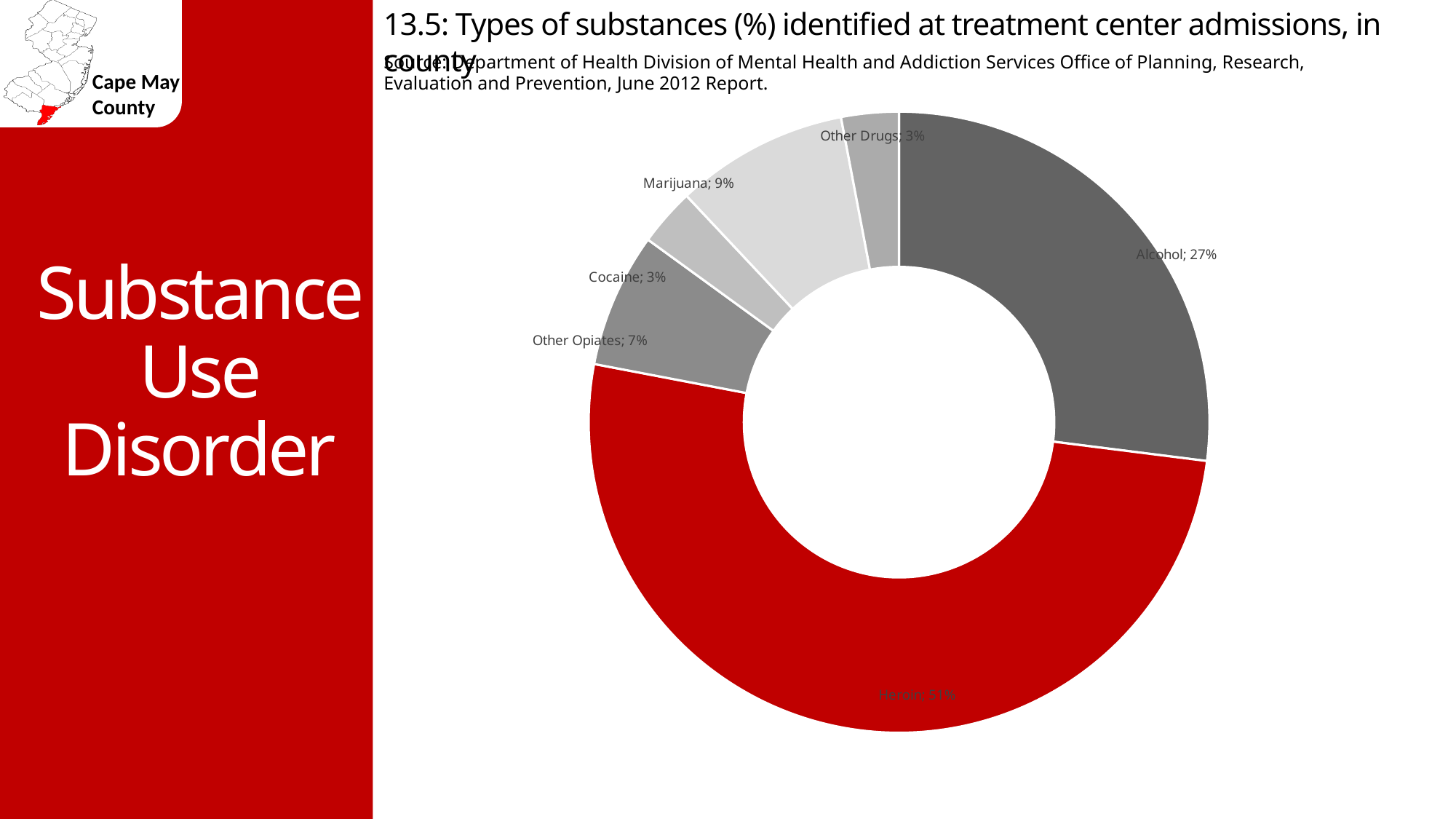
What kind of chart is shown on the slide? doughnut chart What percentage of treatment center admissions is attributed to Heroin? 51% What percentage is shown for Cocaine? 3% What percentage is shown for Marijuana? 9% Which substance has the largest share of admissions? Heroin What is the difference in percentage points between Marijuana and Other Opiates? 2 What is the combined share of Heroin and Alcohol? 78% Which has a larger share, Alcohol or Marijuana? Alcohol What percentage is shown for Other Opiates? 7% What is the difference in percentage points between Heroin and Alcohol? 24 How many substance categories are shown in the chart? 6 What percentage is shown for Alcohol? 27%